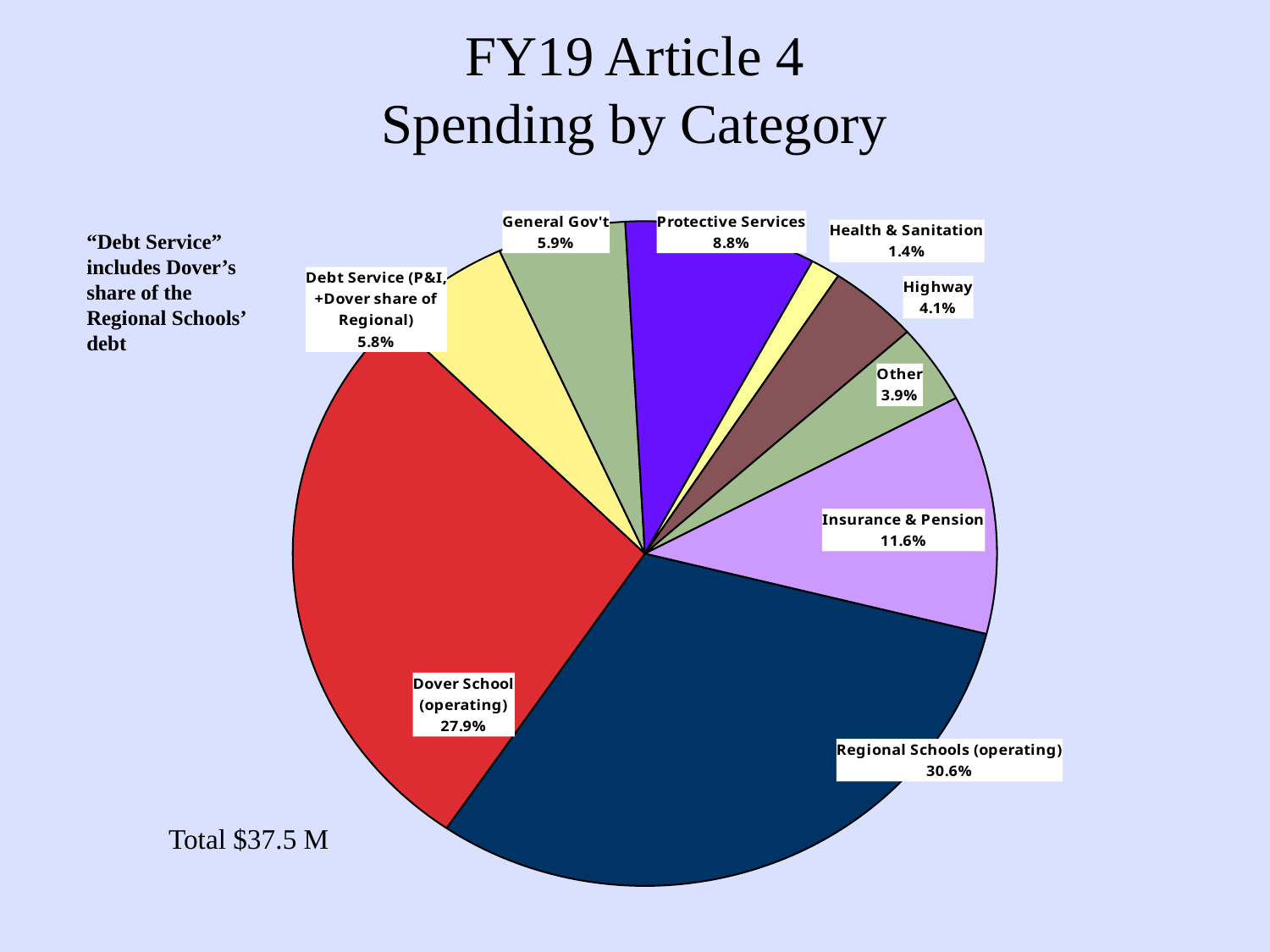
What share of spending goes to Regional Schools (operating)? 30.6% What is the difference in percentage points between Regional Schools (operating) and Dover School (operating)? 2.7 percentage points Which category has the largest share of spending? Regional Schools (operating) What kind of chart is shown on the slide? pie chart What share of spending goes to Dover School (operating)? 27.9% Which is larger, the share for Highway or the share for Other? Highway What is the title of the chart on the slide? FY19 Article 4 Spending by Category How many categories are shown in the pie chart? 9 What percentage is shown for Insurance & Pension? 11.6% Which category has the smallest share of spending? Health & Sanitation What percentage is shown for Protective Services? 8.8% What percentage is shown for Health & Sanitation? 1.4%